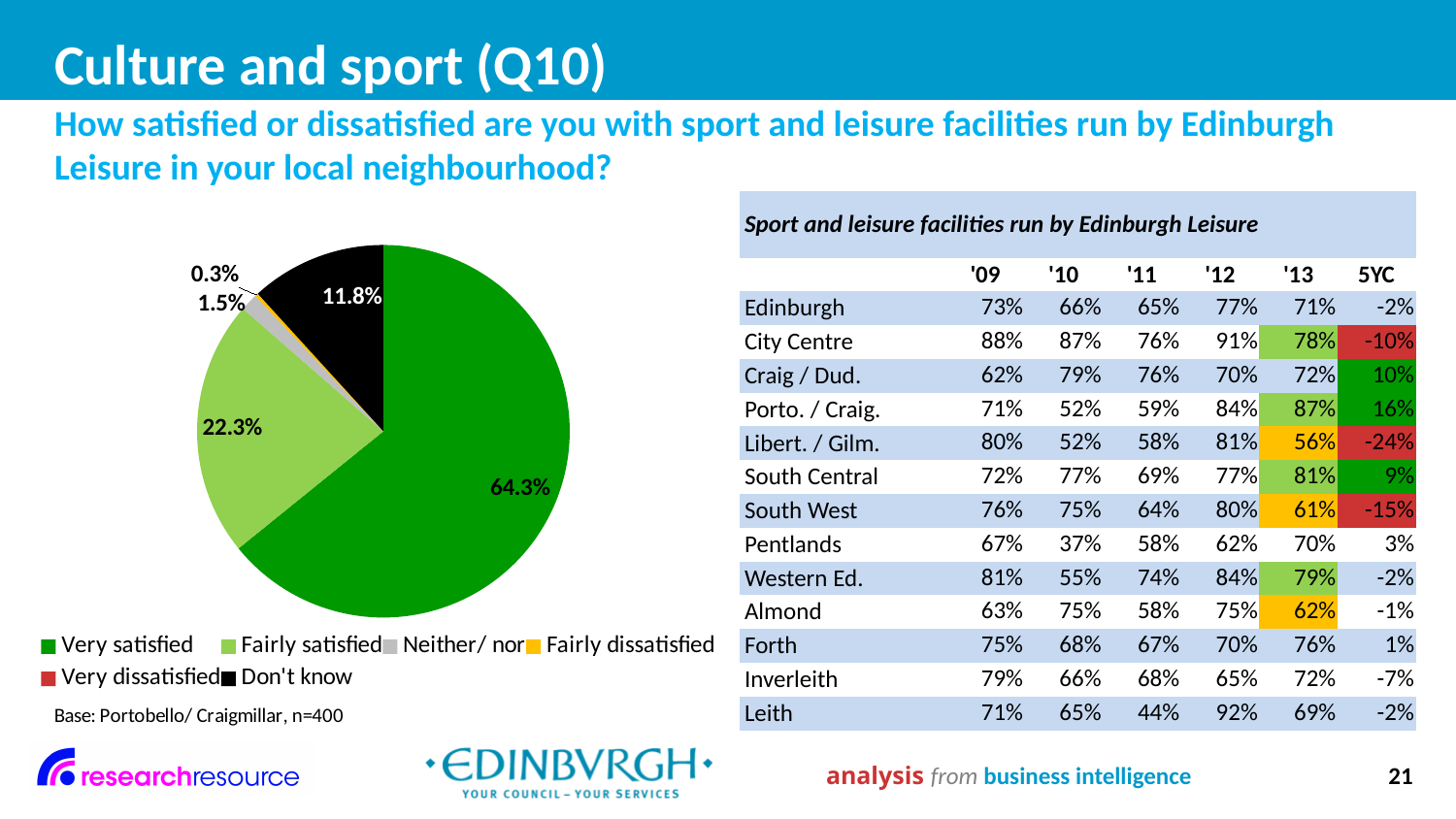
What kind of chart is shown on the slide? pie chart What is the value for 'Neither/ nor' in the pie chart? 1.5% Which labelled slice of the pie is the smallest? Fairly dissatisfied What is the value for 'Don't know' in the pie chart? 11.8% What is the base stated below the pie chart? Portobello/ Craigmillar, n=400 What is the difference between the 'Very satisfied' and 'Fairly satisfied' values? 42.0% What is the value for 'Fairly dissatisfied' in the pie chart? 0.3% Which is larger, 'Don't know' or 'Fairly satisfied'? Fairly satisfied Which category has the largest slice of the pie? Very satisfied What is the value for 'Fairly satisfied' in the pie chart? 22.3% What share of the pie is 'Very satisfied'? 64.3% How many entries does the pie chart legend list? 6